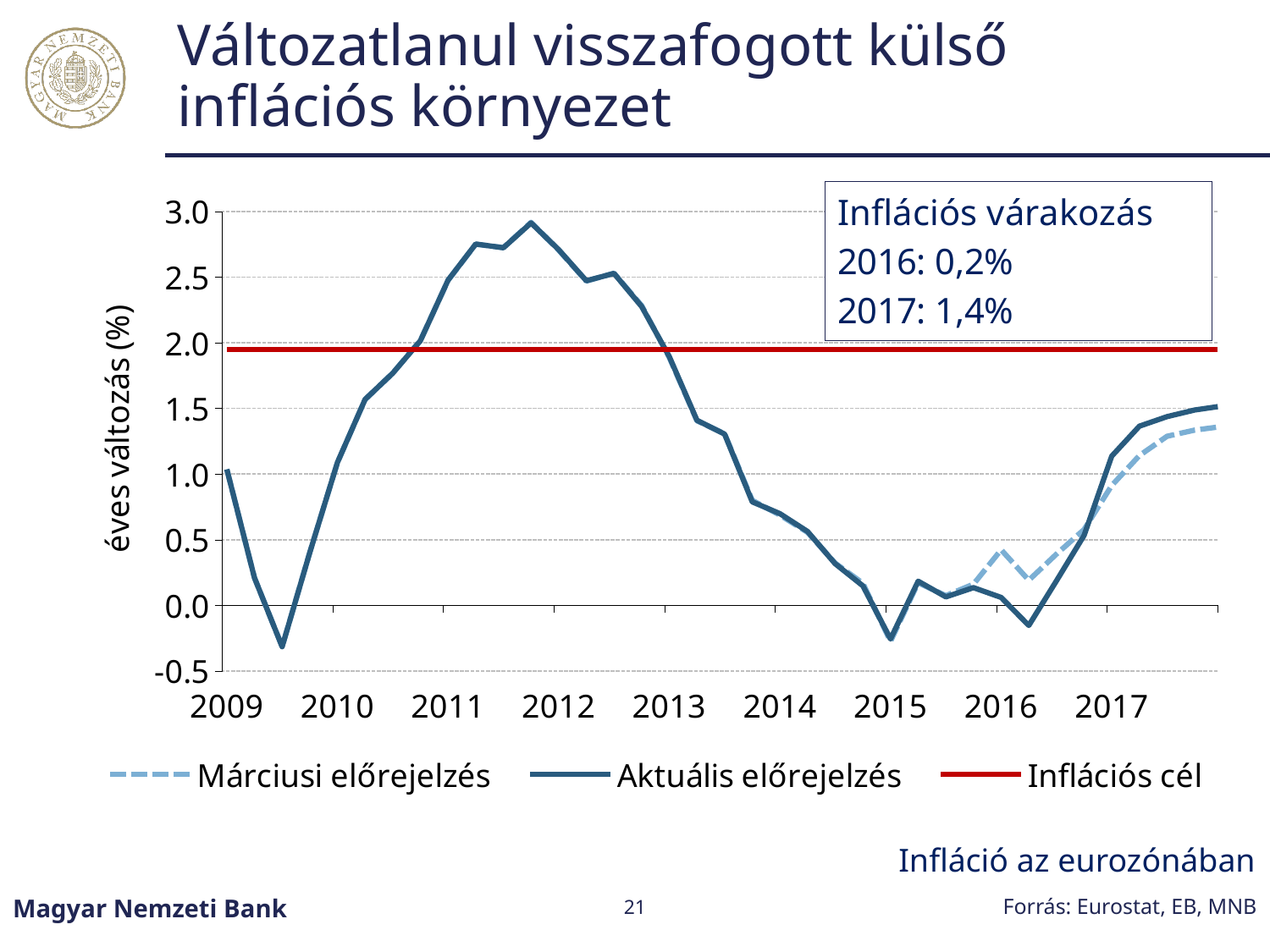
Is the peak value of the Aktuális előrejelzés line around 2012 greater or less than 2.5? greater What kind of chart is shown on the slide? line chart What is the label of the vertical axis? éves változás (%) What are the three legend entries of the chart? Márciusi előrejelzés, Aktuális előrejelzés, Inflációs cél How many year labels are shown on the x axis? 9 Does the Aktuális előrejelzés line rise or fall between 2012 and 2015? fall Is the value of the Aktuális előrejelzés line at the start of 2015 greater or less than 0.0? less How many series does the legend list? 3 Is the Inflációs cél line greater or less than 1.5? greater According to the text box, what is the inflation expectation (Inflációs várakozás) for 2016? 0,2% Does the Aktuális előrejelzés line rise or fall between mid-2016 and the end of 2017? rise According to the text box, what is the inflation expectation (Inflációs várakozás) for 2017? 1,4%